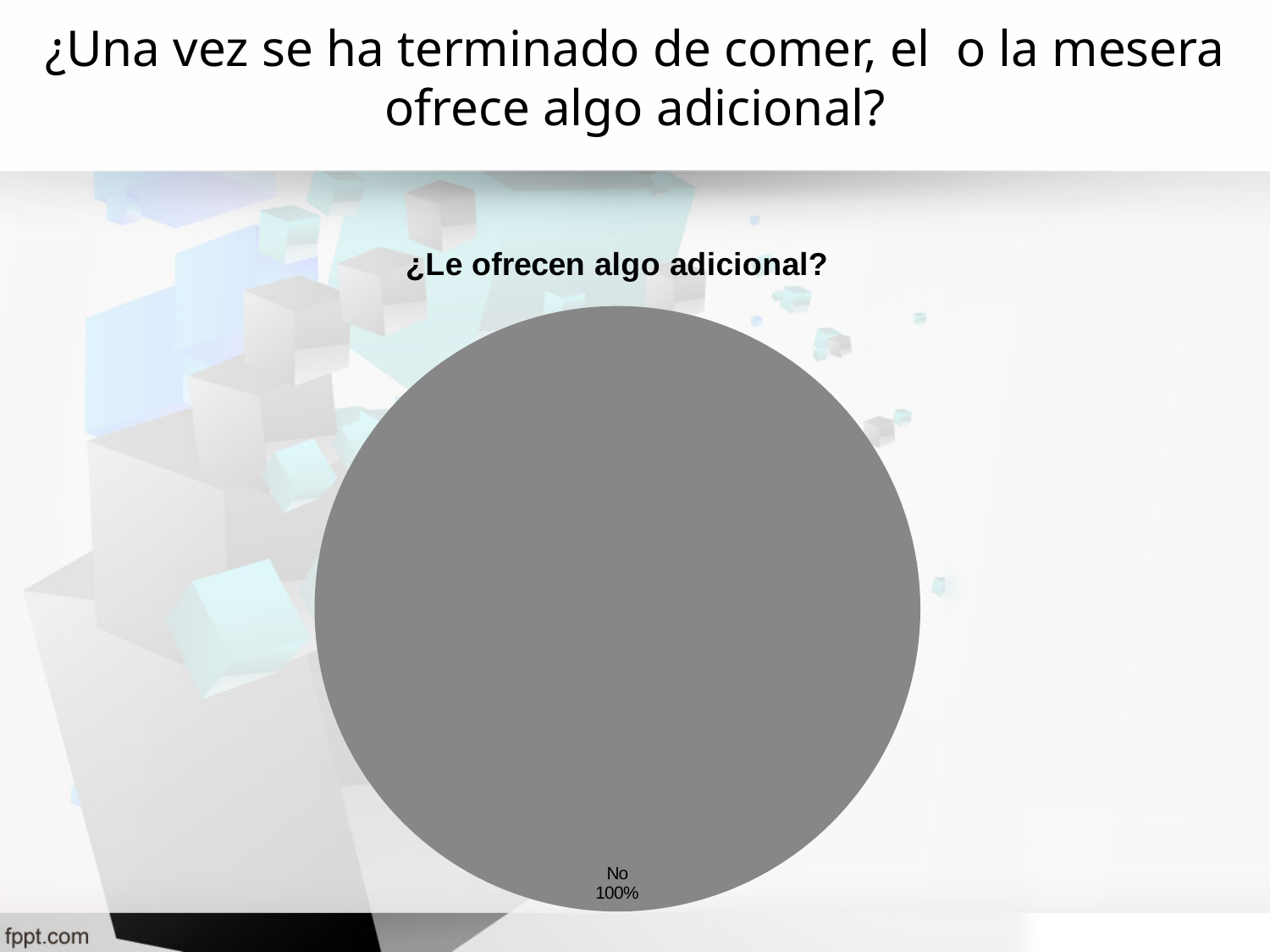
What share of the pie does the "No" slice represent? 100% How many slices are shown in the pie chart? 1 What is the value labelled for the "No" category? 100% What colour is the "No" slice of the pie? grey What is the title of the chart? ¿Le ofrecen algo adicional? Which category makes up the entire pie? No What kind of chart is shown on the slide? pie chart